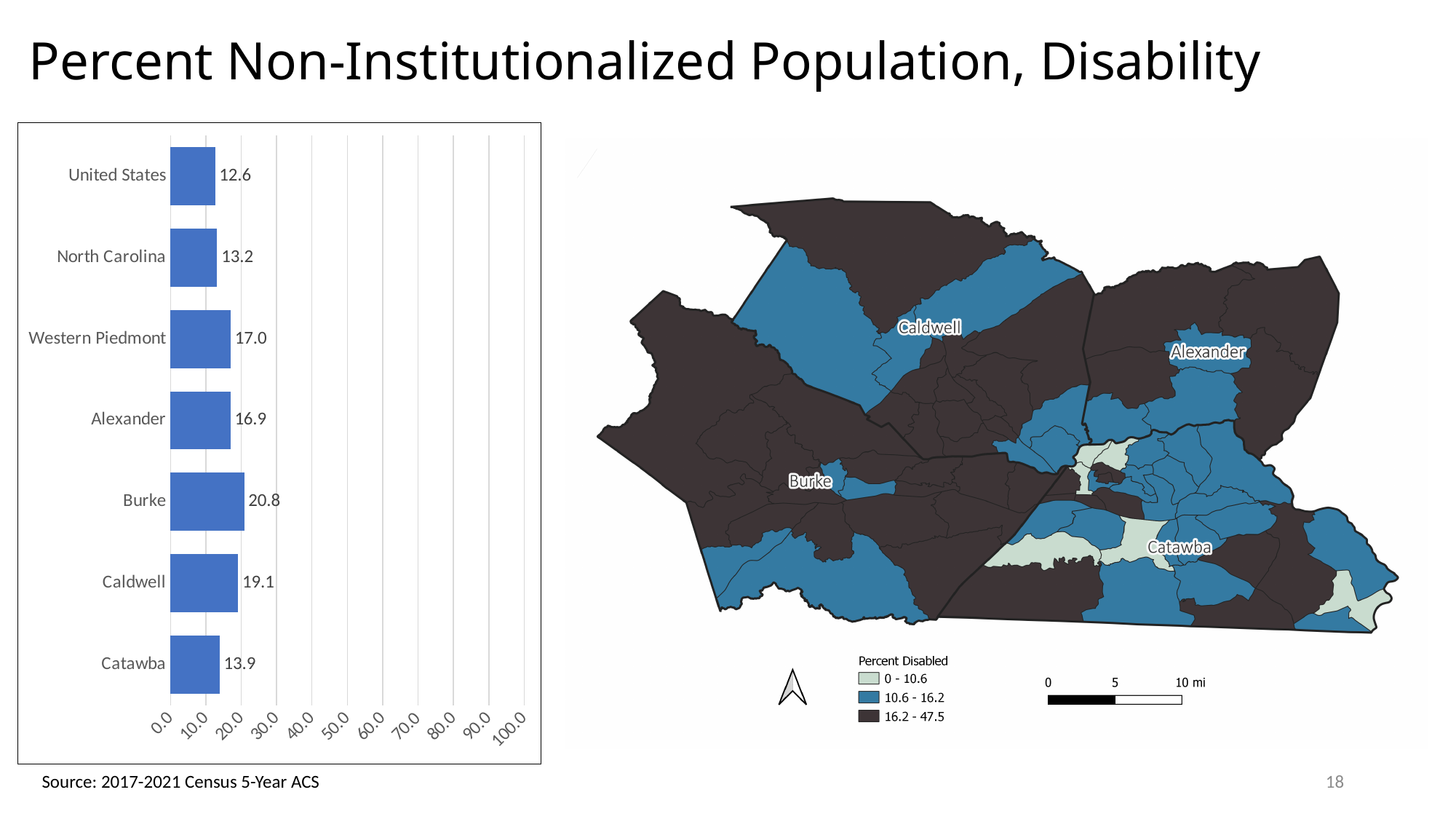
Which category has the highest value in the bar chart? Burke Which has a larger value in the bar chart, Caldwell or Catawba? Caldwell Which category has the lowest value in the bar chart? United States What kind of chart is shown on the left of the slide? bar chart What is the value for Western Piedmont in the bar chart? 17.0 What is the value for Burke in the bar chart? 20.8 Is the value for Burke in the bar chart greater or less than 20.0? greater What is the highest value on the x axis of the bar chart? 100.0 How many categories are shown in the bar chart? 7 What is the difference between the values for Caldwell and Alexander in the bar chart? 2.2 What is the difference between the values for Burke and Catawba in the bar chart? 6.9 What is the value for North Carolina in the bar chart? 13.2